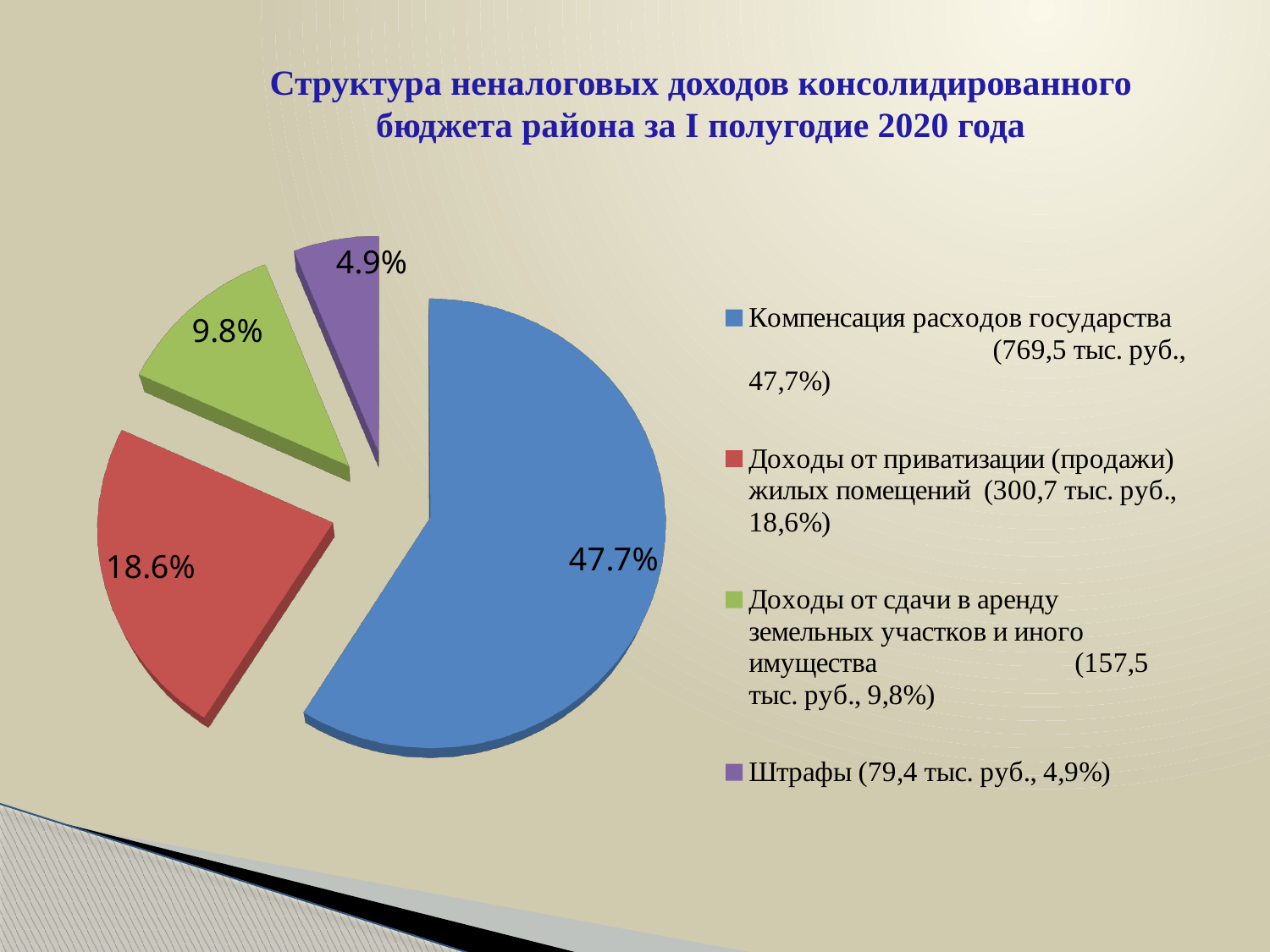
Which is larger: the slice for Доходы от приватизации (продажи) жилых помещений or the slice for Доходы от сдачи в аренду земельных участков и иного имущества? Доходы от приватизации (продажи) жилых помещений What share of the pie does the slice for Доходы от приватизации (продажи) жилых помещений represent? 18.6% Which category has the smallest slice of the pie? Штрафы How many slices does the pie chart have? 4 According to the legend, what is the amount in thousand rubles for Компенсация расходов государства? 769,5 тыс. руб. Which category has the largest slice of the pie? Компенсация расходов государства According to the legend, what is the amount in thousand rubles for Штрафы? 79,4 тыс. руб. What colour is the slice for Штрафы? purple What share of the pie does the slice for Доходы от сдачи в аренду земельных участков и иного имущества represent? 9.8% What share of the pie does the slice for Компенсация расходов государства represent? 47.7% What kind of chart is shown on the slide? pie chart